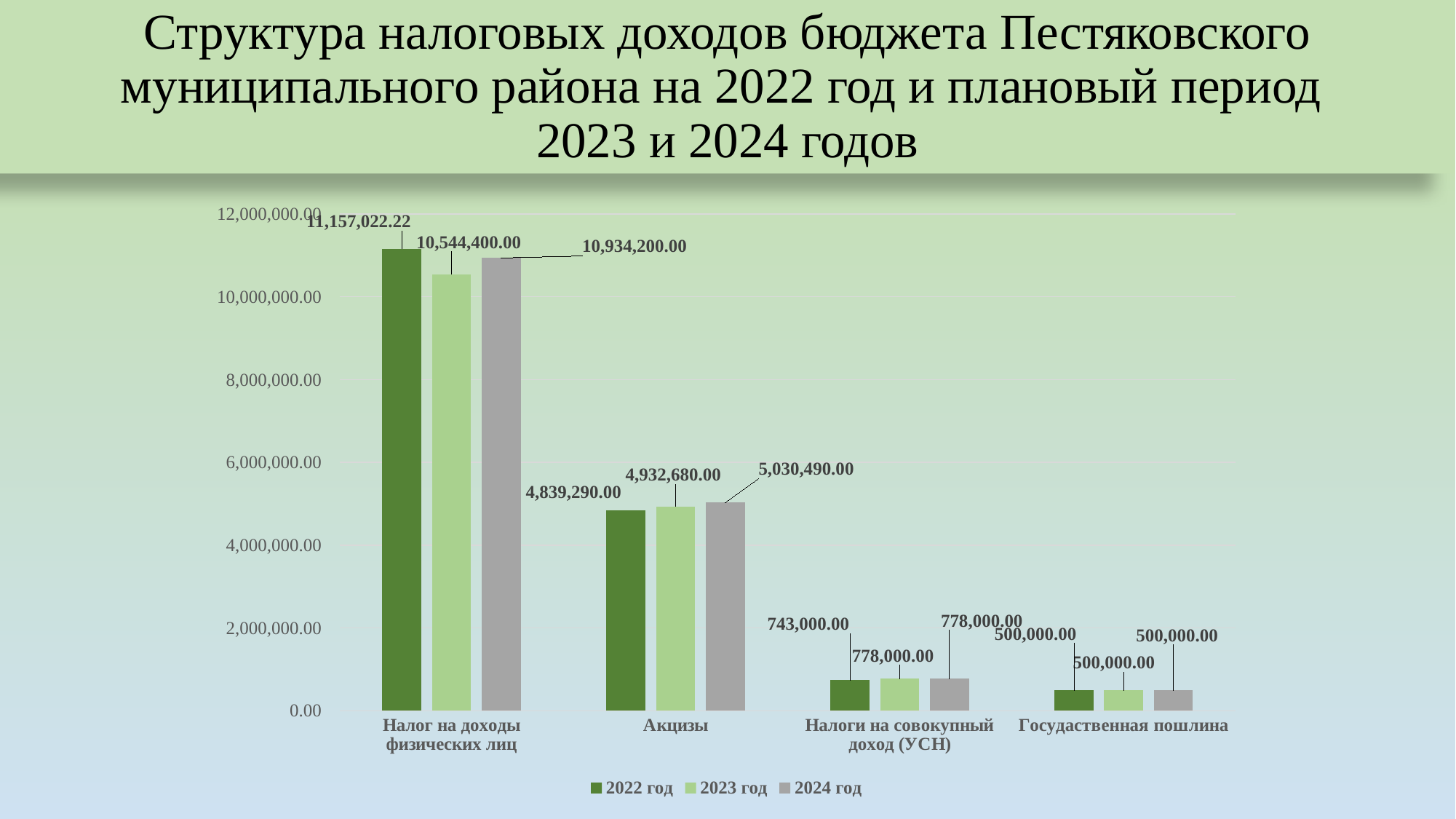
How many categories are shown on the x axis? 4 What is the value for Государственная пошлина in 2023 год? 500,000.00 What kind of chart is shown on the slide? bar chart What is the value for Налоги на совокупный доход (УСН) in 2022 год? 743,000.00 Which category has the lowest value in 2024 год? Государственная пошлина What is the value for Налог на доходы физических лиц in 2022 год? 11,157,022.22 Which is larger for Налог на доходы физических лиц: the 2022 год value or the 2023 год value? 2022 год Do the values for Акцизы rise or fall from 2022 год to 2024 год? rise What is the value for Акцизы in 2024 год? 5,030,490.00 What is the difference between the 2024 год and 2023 год values for Акцизы? 97,810.00 How many series does the legend list? 3 Which category has the highest value in 2023 год? Налог на доходы физических лиц